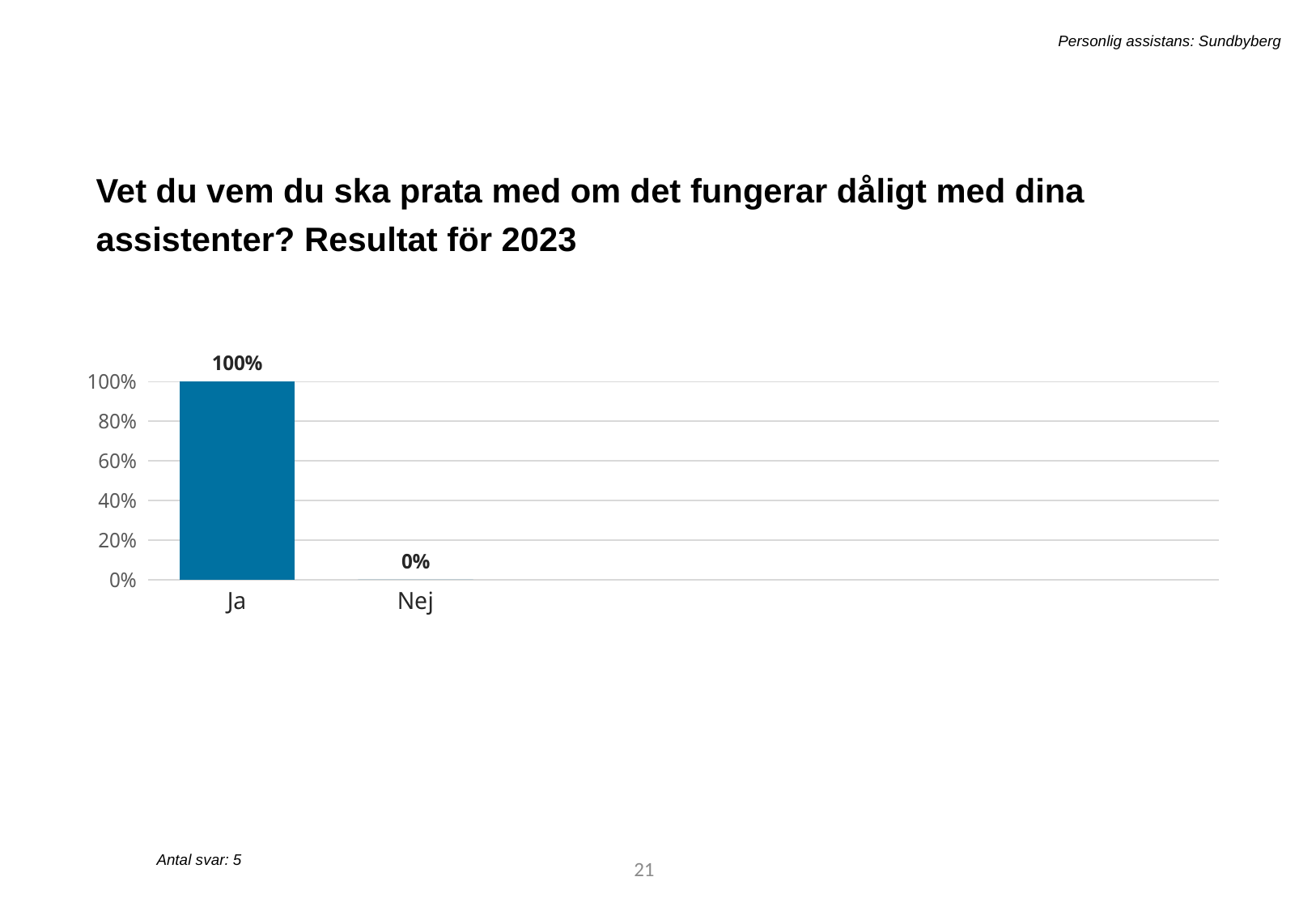
Which is larger, the value for Ja or the value for Nej? Ja Do the values rise or fall from Ja to Nej? fall What is the value for Ja? 100% What is the difference between the values for Ja and Nej? 100% How many responses (Antal svar) does the slide report? 5 What is the value for Nej? 0% How many categories are shown on the x axis? 2 Which category has the highest value? Ja Is the value for Ja greater or less than 60%? greater Which category has the lowest value? Nej What is the highest value shown on the y axis? 100% What kind of chart is shown on the slide? bar chart